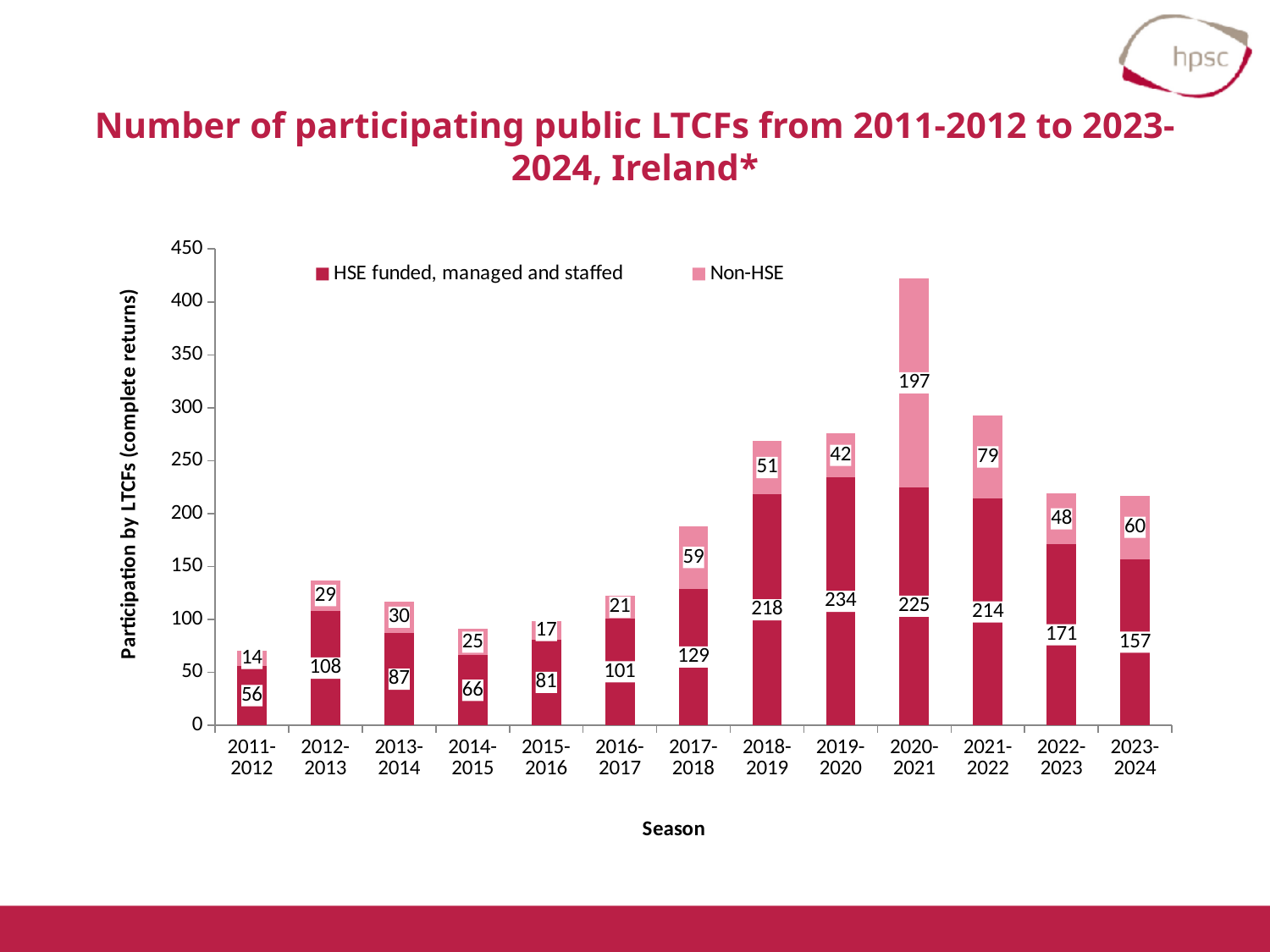
How many seasons are shown on the x axis? 13 Which season has the highest Non-HSE value? 2020-2021 What is the difference between the HSE funded, managed and staffed values for 2018-2019 and 2023-2024? 61 Is the total stacked bar for 2017-2018 greater or less than 150? greater Which season has the lowest HSE funded, managed and staffed value? 2011-2012 What is the label of the y axis? Participation by LTCFs (complete returns) How many series does the legend list? 2 What is the Non-HSE value for the 2020-2021 season? 197 What type of chart is shown on the slide? Stacked bar chart What is the total number of participating LTCFs in the 2020-2021 season (both series combined)? 422 What is the value for HSE funded, managed and staffed LTCFs in the 2019-2020 season? 234 Which is larger: the Non-HSE value for 2021-2022 or for 2022-2023? 2021-2022